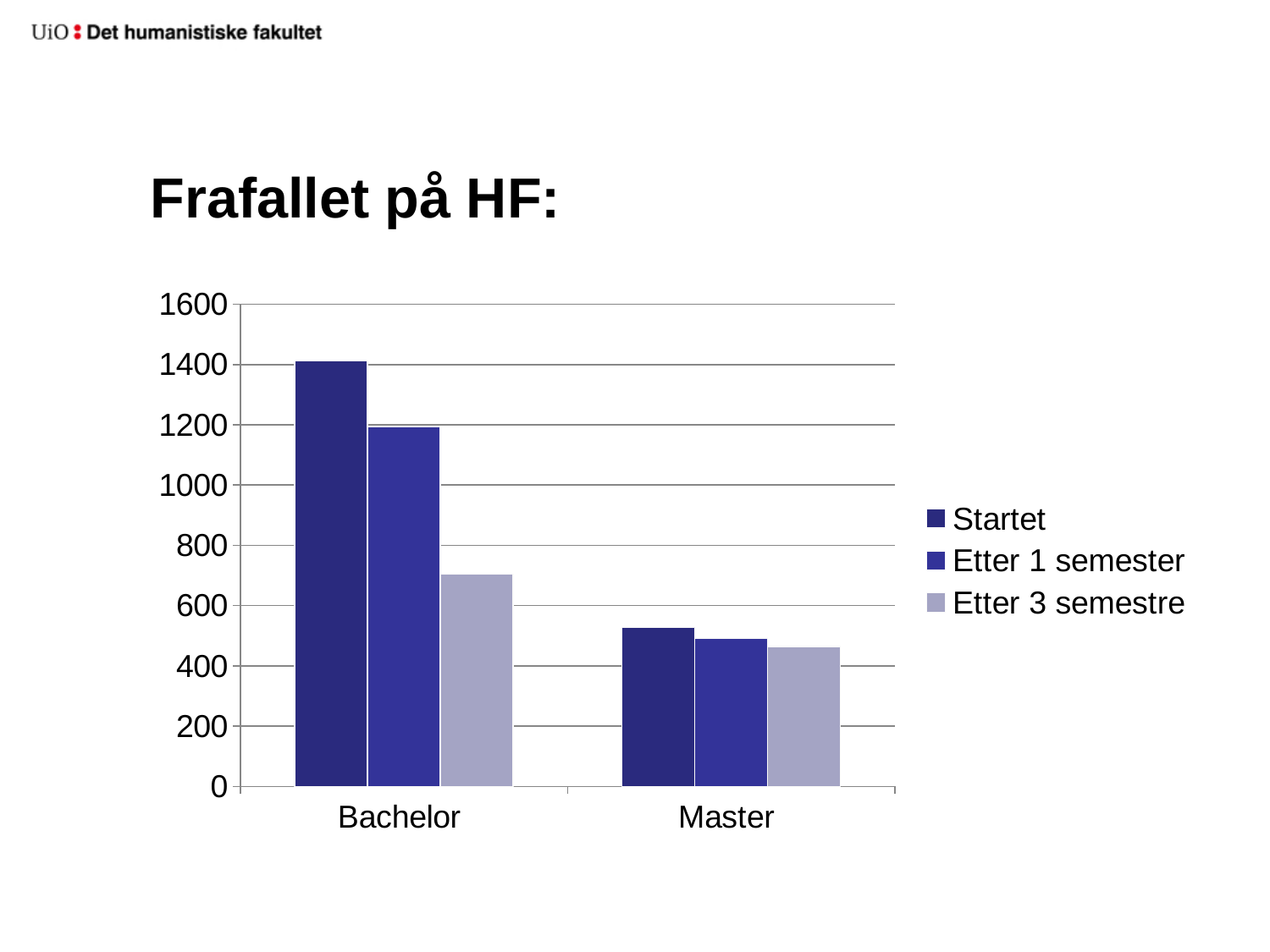
Within the Bachelor category, do the values rise or fall from Startet to Etter 3 semestre? fall Is the Etter 3 semestre value for Bachelor greater or less than 800? less Is the Startet value for Bachelor greater or less than 1200? greater What is the title of the slide above the chart? Frafallet på HF: Is the Etter 1 semester value for Bachelor greater or less than 1000? greater Which category has the lowest Startet value? Master Which is larger, the Etter 3 semestre value for Bachelor or the Etter 3 semestre value for Master? Bachelor How many series does the legend list? 3 How many categories are shown on the x axis? 2 Which category has the highest Startet value? Bachelor What kind of chart is shown on the slide? bar chart